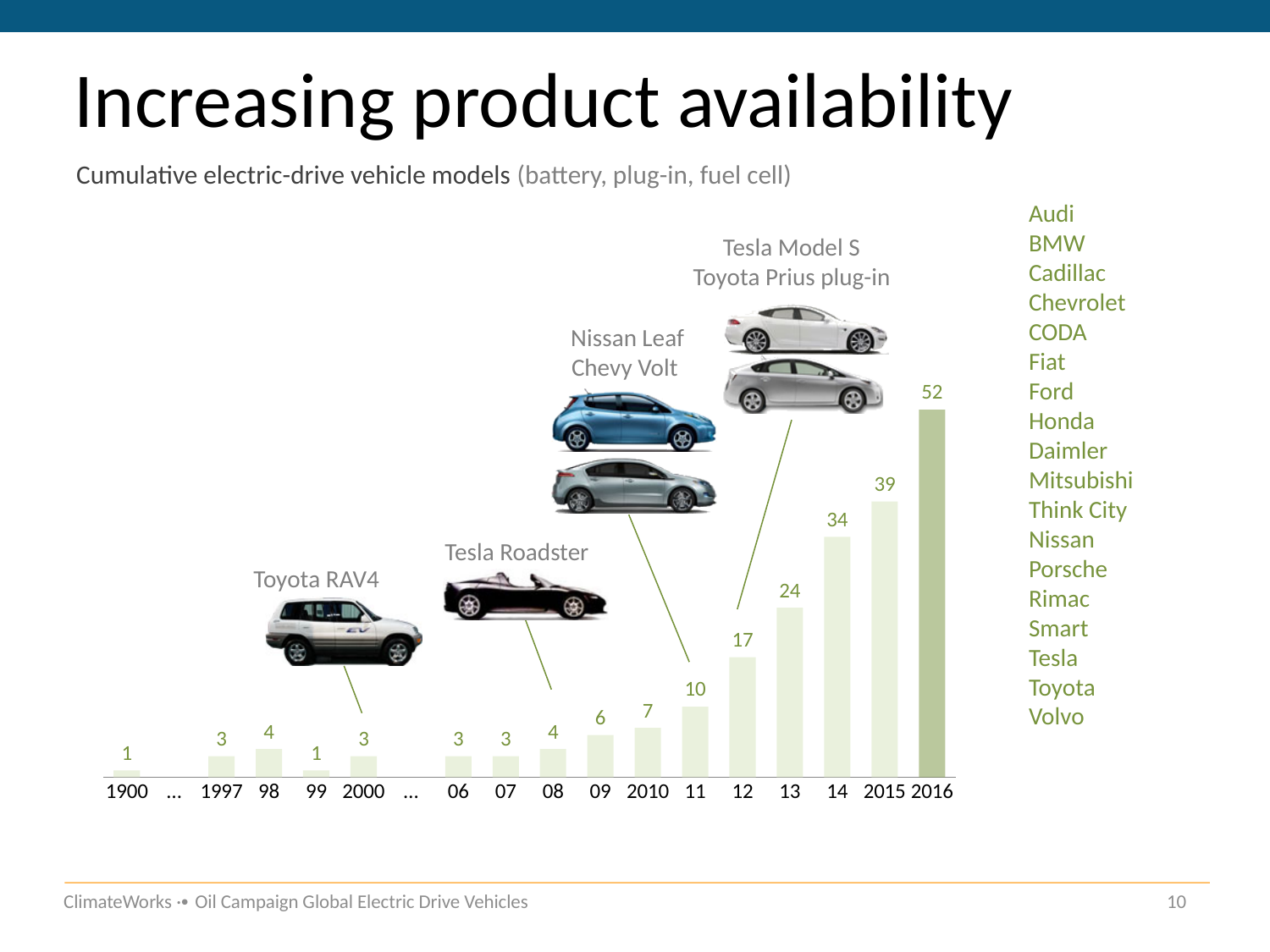
What is the difference between the values for 2016 and 2015? 13 What is the value for 2010? 7 How many bars are plotted in the chart? 16 Which is larger, the value for 2013 or the value for 2011? 2013 Do the values rise or fall from 2006 to 2016? rise What is the value for 2016? 52 Which year has the highest value? 2016 What is the difference between the values for 2014 and 2012? 17 What kind of chart is shown on the slide? bar chart What is the value for 1998? 4 What is the value for 2012? 17 Which vehicle models are labelled above the 2011 bar? Nissan Leaf, Chevy Volt